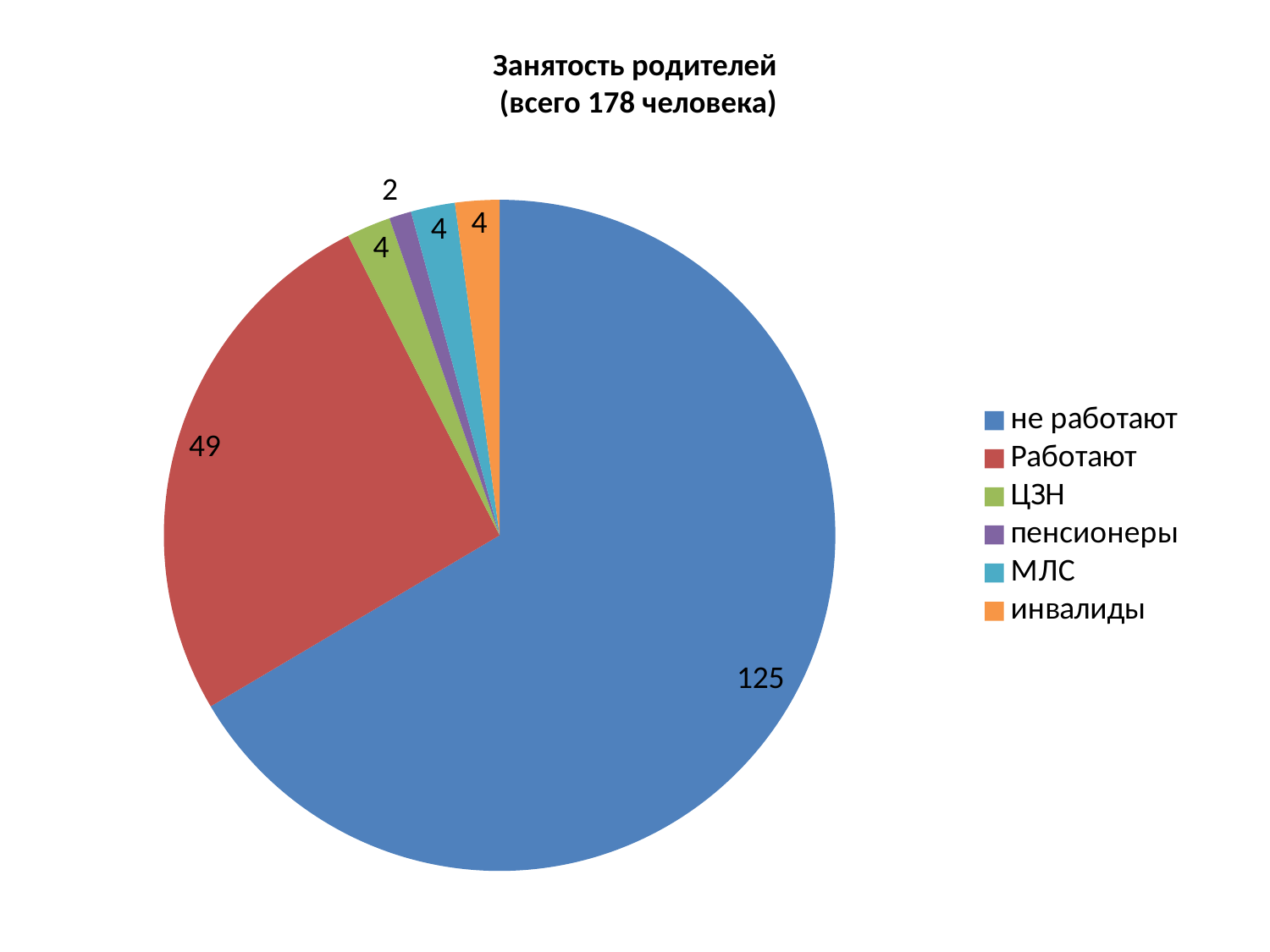
What type of chart is shown on the slide? pie chart What is the title of the chart? Занятость родителей (всего 178 человека) What is the difference between the 'не работают' and 'Работают' values? 76 How many entries does the legend list? 6 How many categories does the pie chart have? 6 What is the value for the 'не работают' slice? 125 What is the value for the 'пенсионеры' slice? 2 Which is larger, the value for 'Работают' or the value for 'МЛС'? Работают What is the value for the 'Работают' slice? 49 Which category has the smallest slice? пенсионеры Which category has the largest slice? не работают What is the value for the 'ЦЗН' slice? 4